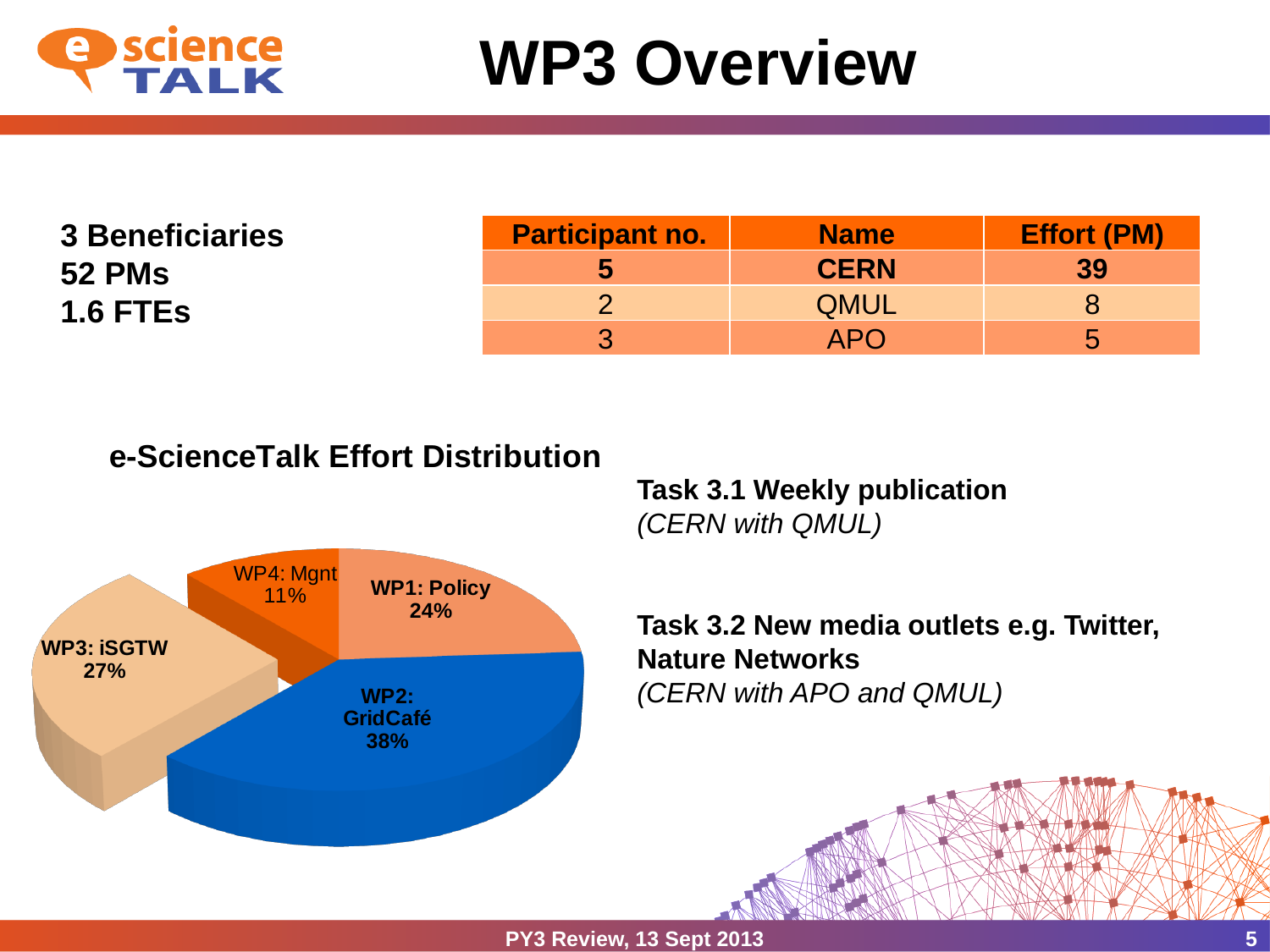
What is the title of the pie chart? e-ScienceTalk Effort Distribution What is the combined share of WP1: Policy and WP4: Mgnt in the pie chart? 35% What is the difference in percentage points between WP2: GridCafé and WP3: iSGTW in the pie chart? 11 What share of effort does WP4: Mgnt have in the pie chart? 11% What share of effort does WP3: iSGTW have in the pie chart? 27% Which work package has the largest slice in the pie chart? WP2: GridCafé Which has a larger share in the pie chart, WP1: Policy or WP3: iSGTW? WP3: iSGTW How many slices does the pie chart have? 4 What share of effort does WP1: Policy have in the pie chart? 24% What type of chart is the e-ScienceTalk Effort Distribution chart? pie chart Which work package has the smallest slice in the pie chart? WP4: Mgnt